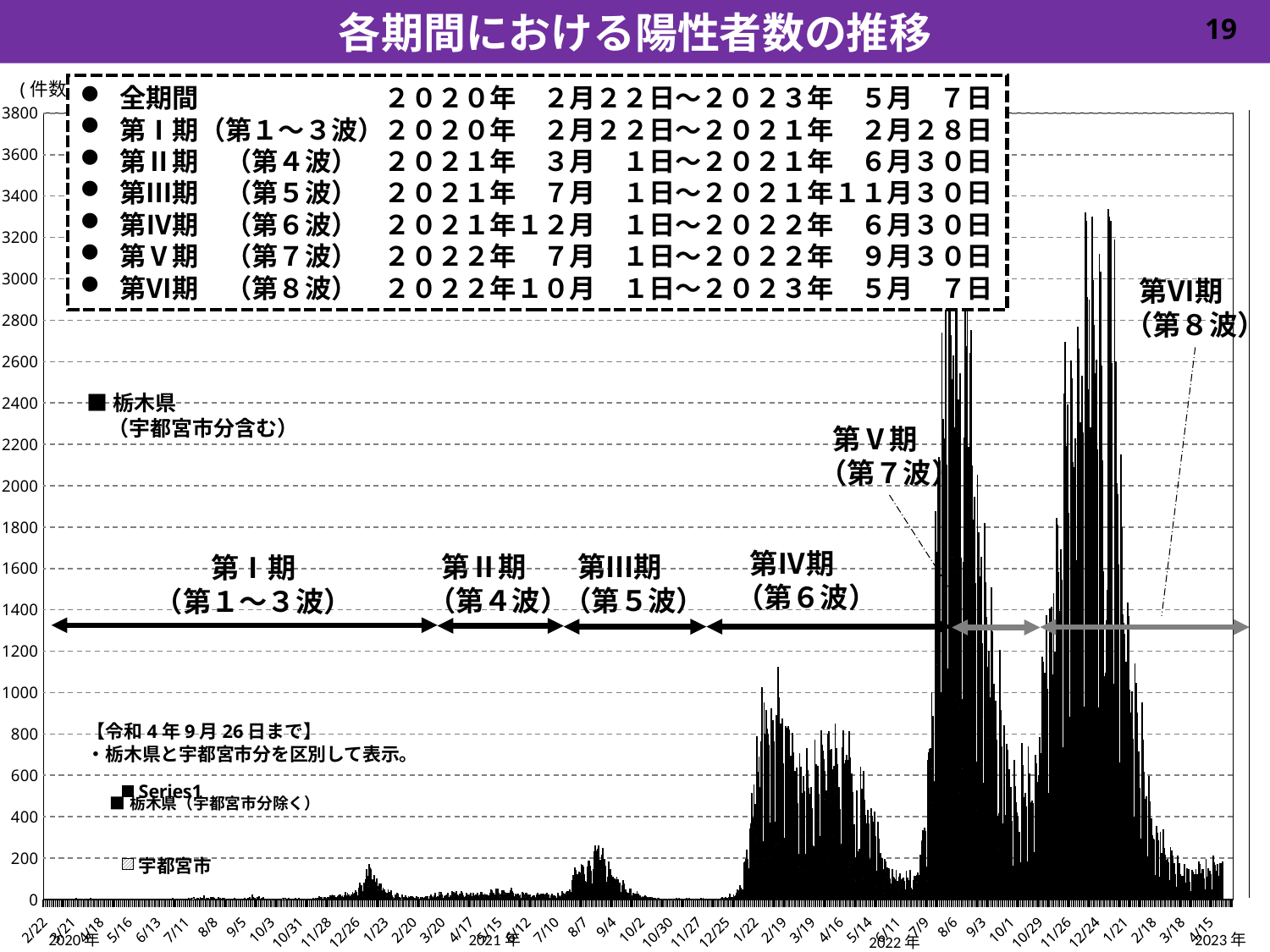
What kind of chart is shown on the slide? bar chart What is the highest tick value shown on the vertical axis? 3800 How many periods (期) are marked along the chart? 6 Is the peak value in 第VI期（第8波） greater or less than 3000? greater Which period has a lower peak, 第I期（第1～3波） or 第VI期（第8波）? 第I期（第1～3波） Is the peak value in 第V期（第7波） greater or less than 2000? greater Is the peak value in 第II期（第4波） greater or less than 200? less Which period has a higher peak, 第III期（第5波） or 第IV期（第6波）? 第IV期（第6波） Which period has the highest peak in positive cases? 第VI期（第8波） What is the title of the chart? 各期間における陽性者数の推移